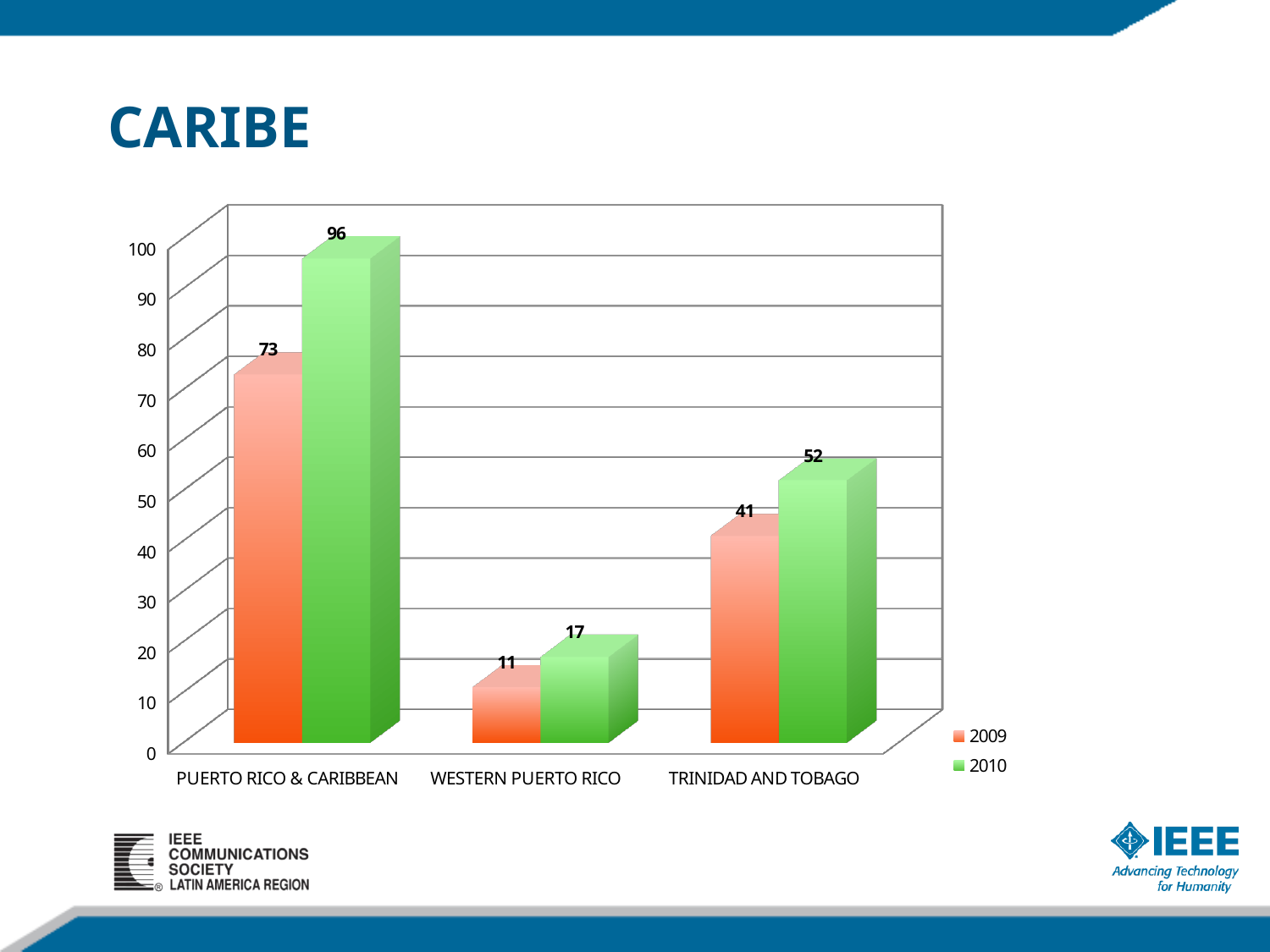
Which category has the highest 2010 value? PUERTO RICO & CARIBBEAN Which is larger: the 2010 value for TRINIDAD AND TOBAGO or the 2009 value for PUERTO RICO & CARIBBEAN? 2009 value for PUERTO RICO & CARIBBEAN What is the 2009 value for TRINIDAD AND TOBAGO? 41 What is the difference between the 2010 and 2009 values for PUERTO RICO & CARIBBEAN? 23 What kind of chart is shown on the slide? Bar chart What is the 2009 value for WESTERN PUERTO RICO? 11 Which category has the lowest 2009 value? WESTERN PUERTO RICO What is the 2010 value for PUERTO RICO & CARIBBEAN? 96 How many series does the legend list? 2 What is the difference between the 2010 and 2009 values for TRINIDAD AND TOBAGO? 11 What is the title of the slide? CARIBE How many categories are shown on the x axis? 3